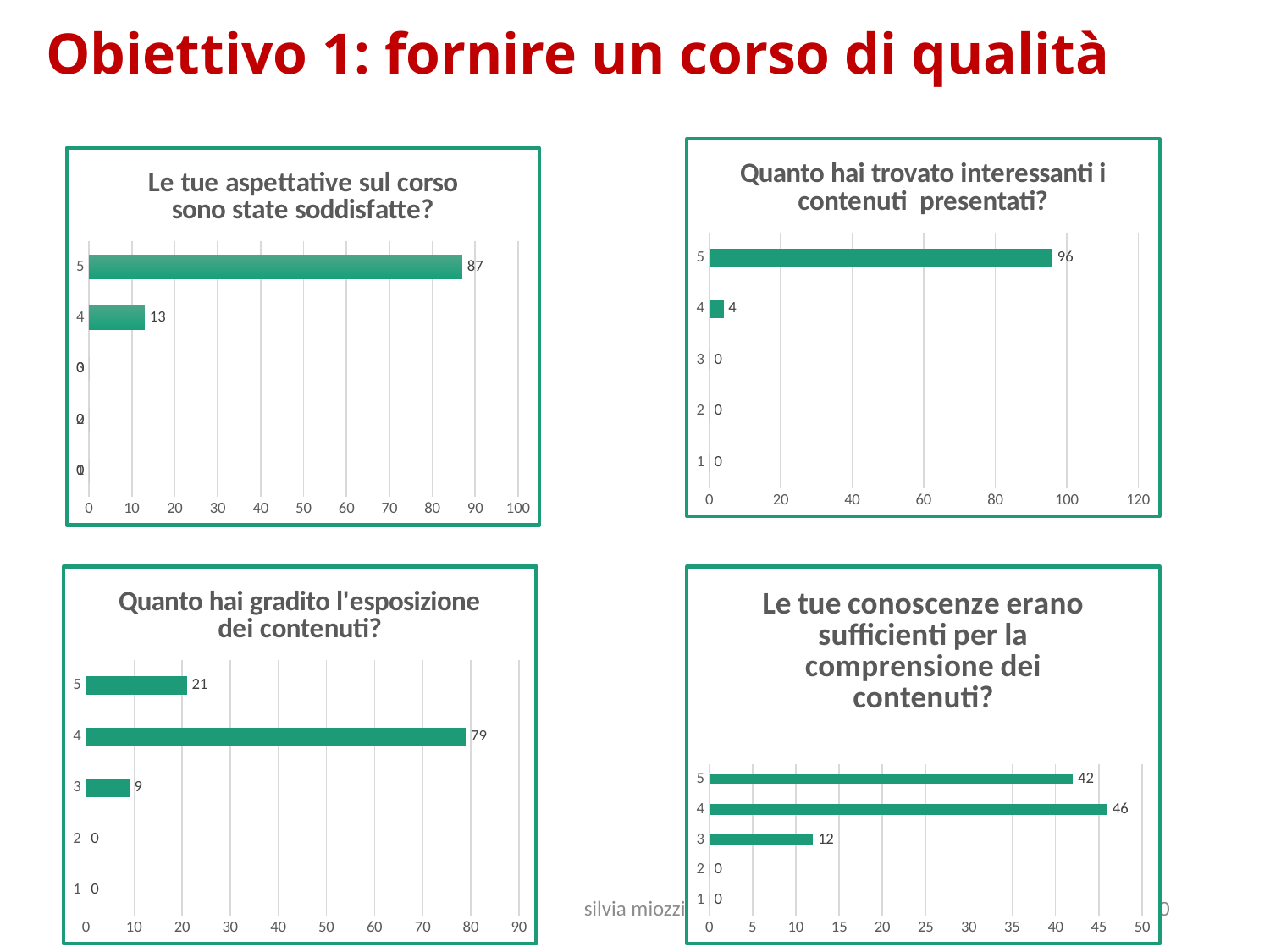
In the chart 'Le tue conoscenze erano sufficienti per la comprensione dei contenuti?', what is the value for category 3? 12 How many categories are shown in the chart 'Quanto hai trovato interessanti i contenuti presentati?'? 5 In the chart 'Quanto hai gradito l'esposizione dei contenuti?', which is larger, the value for category 5 or category 3? 5 In the chart 'Le tue aspettative sul corso sono state soddisfatte?', what is the value for category 4? 13 In the chart 'Quanto hai gradito l'esposizione dei contenuti?', what is the difference between the values for category 4 and category 5? 58 What kind of chart is 'Le tue aspettative sul corso sono state soddisfatte?'? bar chart In the chart 'Quanto hai trovato interessanti i contenuti presentati?', what is the difference between the values for category 5 and category 4? 92 In the chart 'Le tue conoscenze erano sufficienti per la comprensione dei contenuti?', which category has the highest value? 4 In the chart 'Quanto hai trovato interessanti i contenuti presentati?', which category has the highest value? 5 In the chart 'Le tue aspettative sul corso sono state soddisfatte?', what is the value for category 5? 87 In the chart 'Le tue conoscenze erano sufficienti per la comprensione dei contenuti?', what is the difference between the values for category 4 and category 5? 4 In the chart 'Quanto hai gradito l'esposizione dei contenuti?', what is the value for category 4? 79